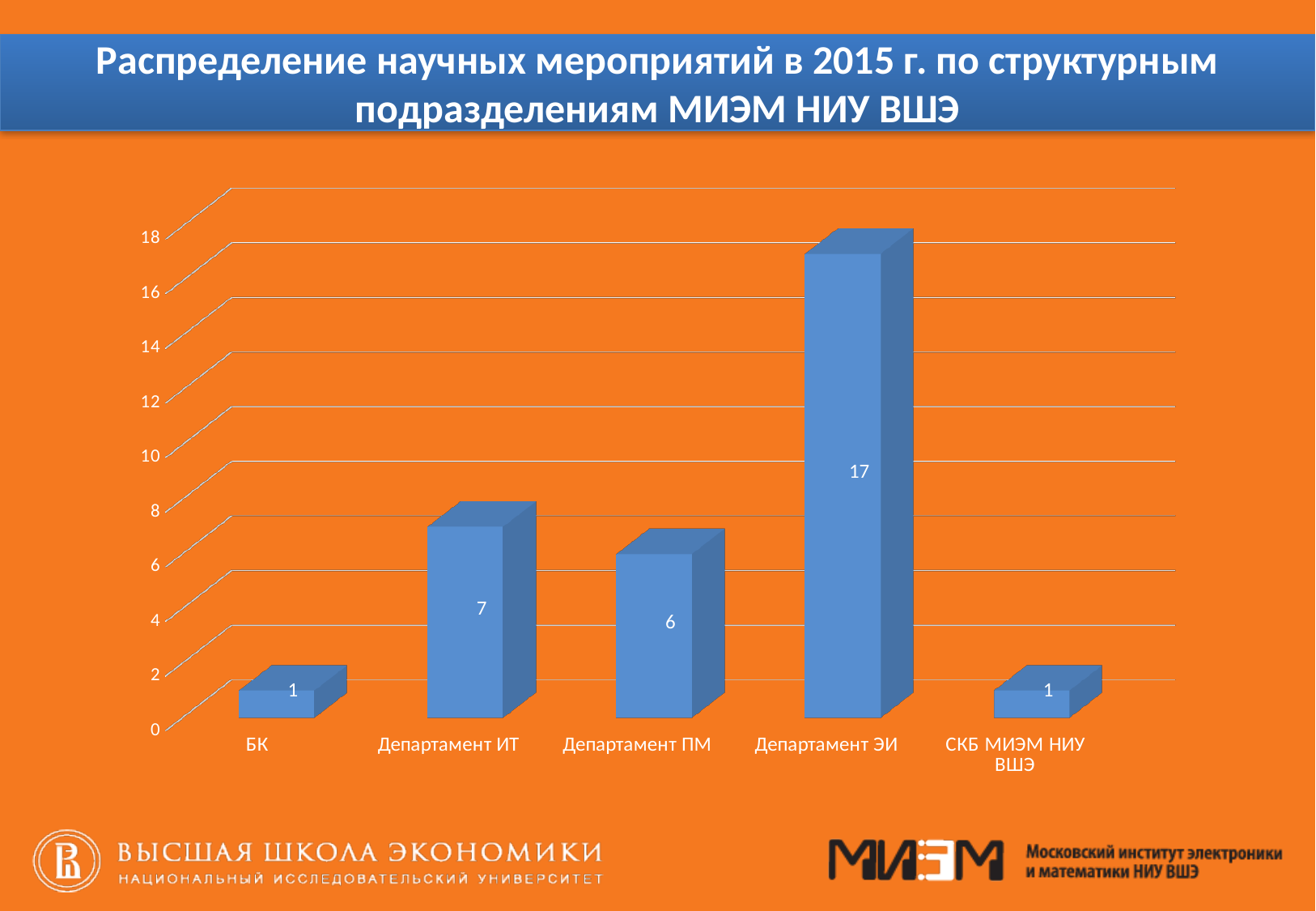
Which category has the highest value? Департамент ЭИ What is the value for Департамент ЭИ? 17 Is the value for Департамент ЭИ greater or less than 10? greater What is the difference between the values for Департамент ЭИ and Департамент ИТ? 10 What kind of chart is shown on the slide? bar chart What is the difference between the values for Департамент ПМ and СКБ МИЭМ НИУ ВШЭ? 5 What is the value for Департамент ИТ? 7 What is the value for Департамент ПМ? 6 What is the title of the chart? Распределение научных мероприятий в 2015 г. по структурным подразделениям МИЭМ НИУ ВШЭ What is the value for БК? 1 Which is larger, the value for Департамент ИТ or Департамент ПМ? Департамент ИТ How many categories are shown on the x axis? 5